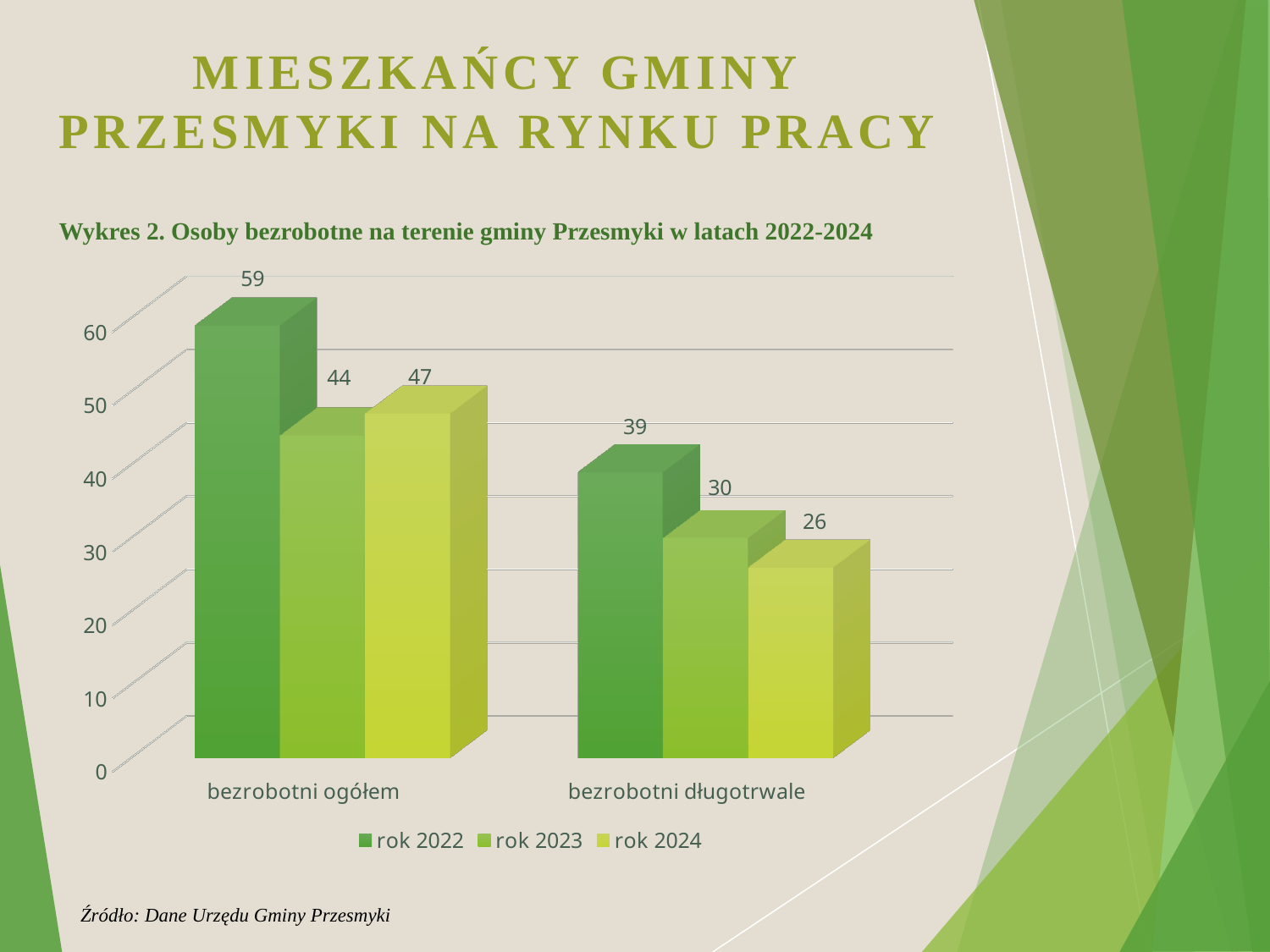
What is the title of the chart? Wykres 2. Osoby bezrobotne na terenie gminy Przesmyki w latach 2022-2024 What is the value for 'rok 2023' in the 'bezrobotni ogółem' category? 44 What is the value for 'rok 2022' in the 'bezrobotni ogółem' category? 59 What kind of chart is shown on the slide? bar chart What is the difference between the 'rok 2022' and 'rok 2024' values in the 'bezrobotni ogółem' category? 12 What is the value for 'rok 2024' in the 'bezrobotni długotrwale' category? 26 Which year has the highest value in the 'bezrobotni długotrwale' category? rok 2022 What is the difference between the 'rok 2023' and 'rok 2024' values in the 'bezrobotni długotrwale' category? 4 How many series does the legend list? 3 Which is larger: the 'rok 2023' value for 'bezrobotni ogółem' or the 'rok 2022' value for 'bezrobotni długotrwale'? rok 2023 value for bezrobotni ogółem How many categories are shown on the x axis of the chart? 2 Which year has the lowest value in the 'bezrobotni ogółem' category? rok 2023